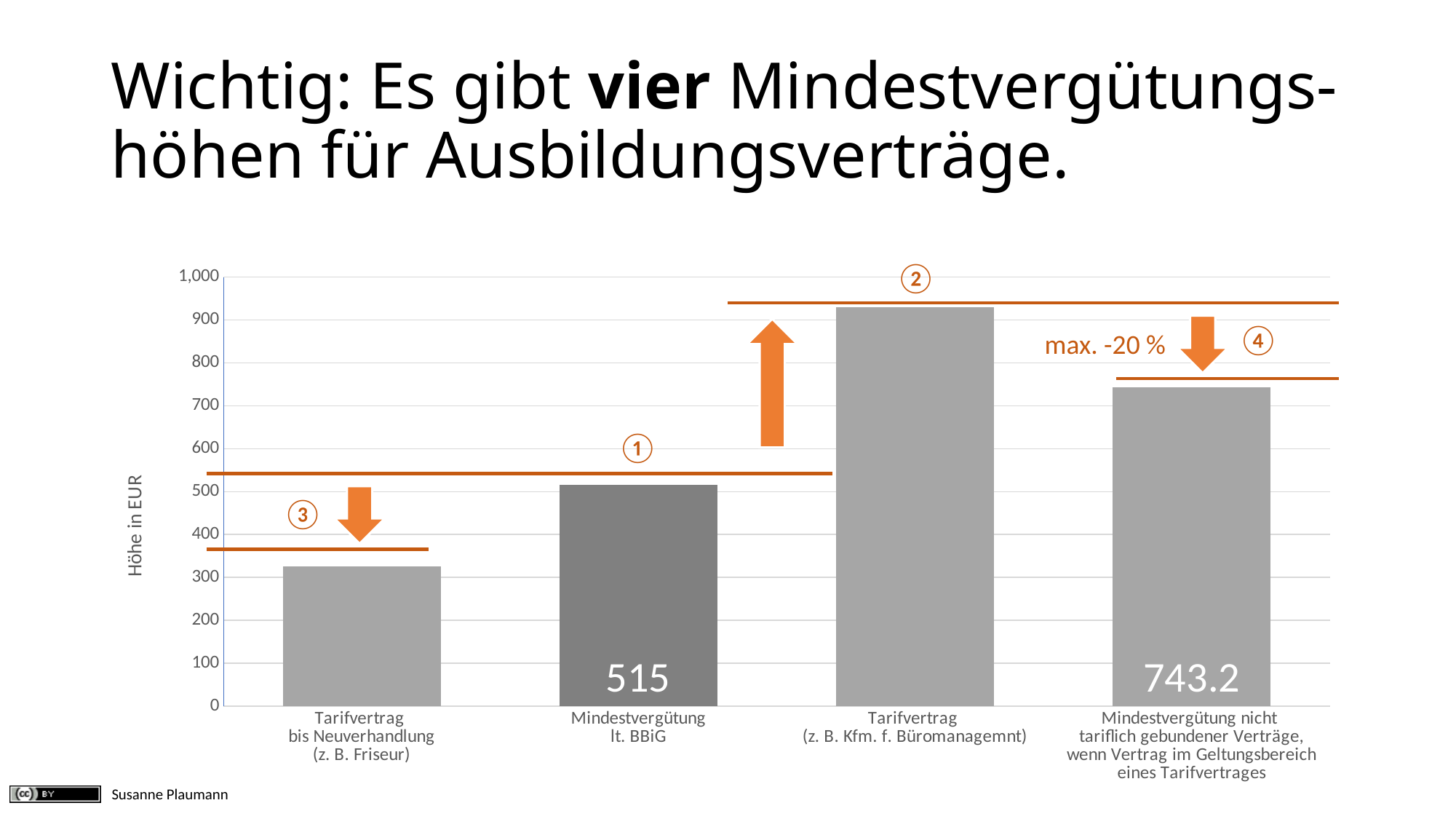
What is the value for Mindestvergütung lt. BBiG? 515 Which is larger: the value for Mindestvergütung lt. BBiG or the value for Mindestvergütung nicht tariflich gebundener Verträge? Mindestvergütung nicht tariflich gebundener Verträge What text is written next to the downward arrow above the rightmost bar? max. -20 % What is the difference between the value for Mindestvergütung nicht tariflich gebundener Verträge and the value for Mindestvergütung lt. BBiG? 228.2 What is the label of the vertical axis? Höhe in EUR What kind of chart is shown on the slide? bar chart What is the value for Mindestvergütung nicht tariflich gebundener Verträge, wenn Vertrag im Geltungsbereich eines Tarifvertrages? 743.2 Is the value for Tarifvertrag bis Neuverhandlung (z. B. Friseur) greater or less than 400? less Is the value for Tarifvertrag (z. B. Kfm. f. Büromanagemnt) greater or less than 900? greater Which category has the lowest bar? Tarifvertrag bis Neuverhandlung (z. B. Friseur) How many categories are shown on the x axis? 4 Which category has the highest bar? Tarifvertrag (z. B. Kfm. f. Büromanagemnt)